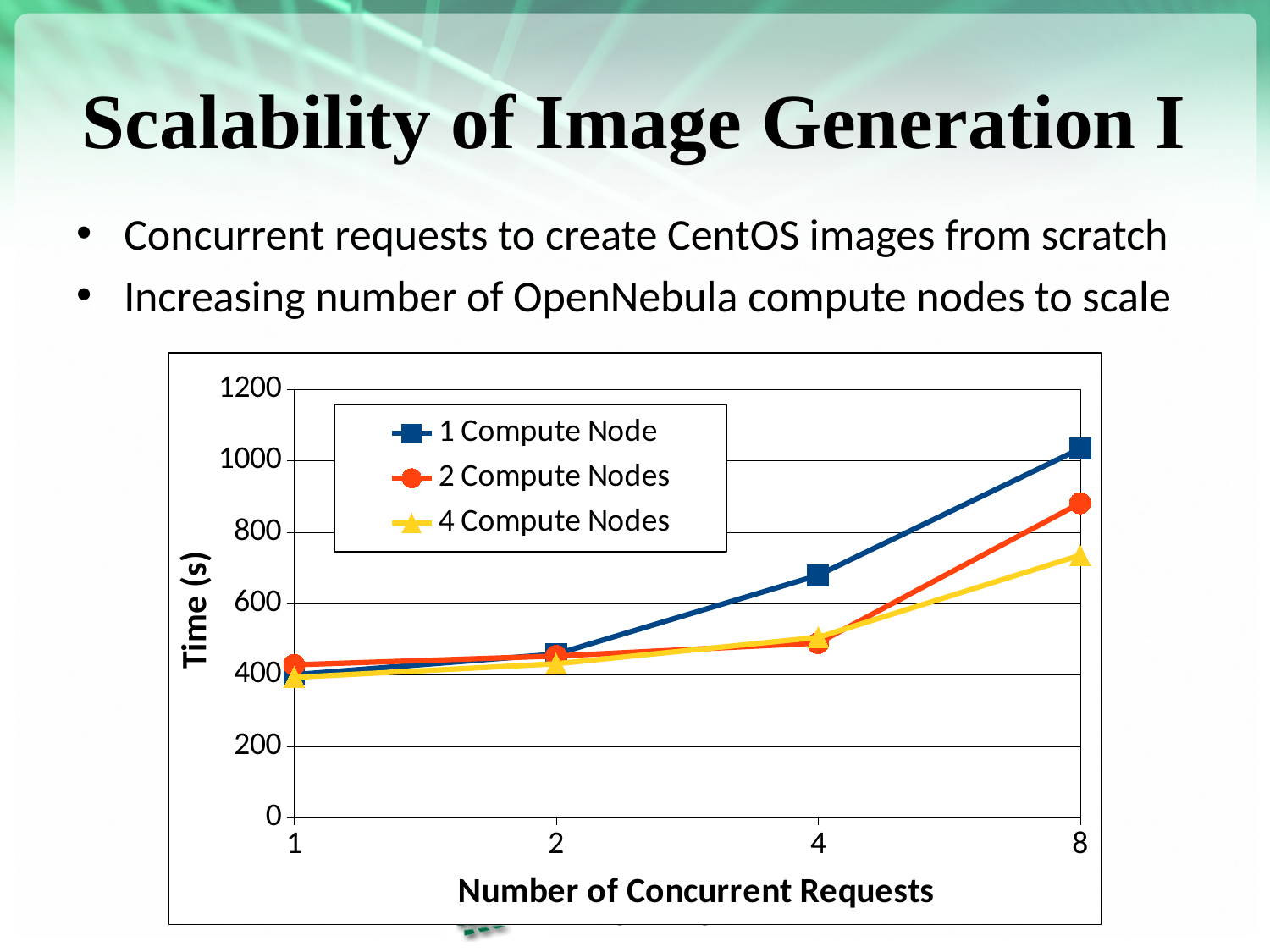
Which series has the highest time at 8 concurrent requests? 1 Compute Node What is the title of the y axis of the chart? Time (s) How many series does the chart legend list? 3 What kind of chart is shown on the slide? line chart How many values of Number of Concurrent Requests are plotted on the x axis? 4 Which series has the lowest time at 8 concurrent requests? 4 Compute Nodes Is the time for 1 Compute Node at 8 concurrent requests greater or less than 800? greater Is the time for 1 Compute Node at 4 concurrent requests greater or less than 600? greater At 8 concurrent requests, which is larger: the time for 1 Compute Node or for 4 Compute Nodes? 1 Compute Node Is the time for 2 Compute Nodes at 4 concurrent requests greater or less than 600? less Does the time for 1 Compute Node rise or fall as the number of concurrent requests increases? rise